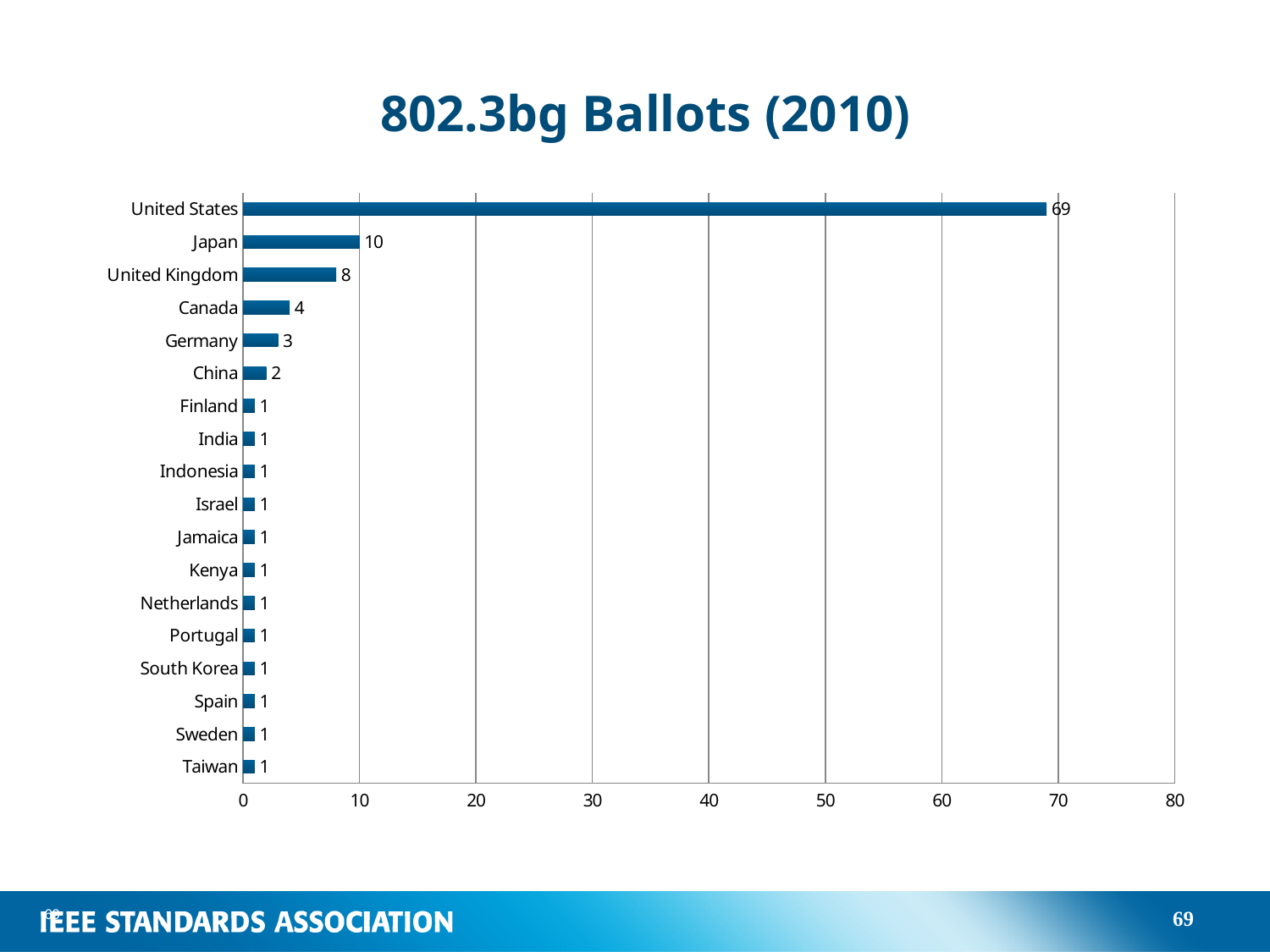
Which is larger, the value for Canada or the value for Germany? Canada What is the difference between the values for the United States and Japan? 59 Which country has the highest number of ballots? United States What is the value for Japan? 10 What is the value for Germany? 3 What is the value for the United States? 69 How many countries are shown on the chart? 18 What is the title of the chart? 802.3bg Ballots (2010) Is the value for the United States greater or less than 60? greater What kind of chart is shown on the slide? Bar chart What is the difference between the values for Canada and China? 2 What is the value for the United Kingdom? 8